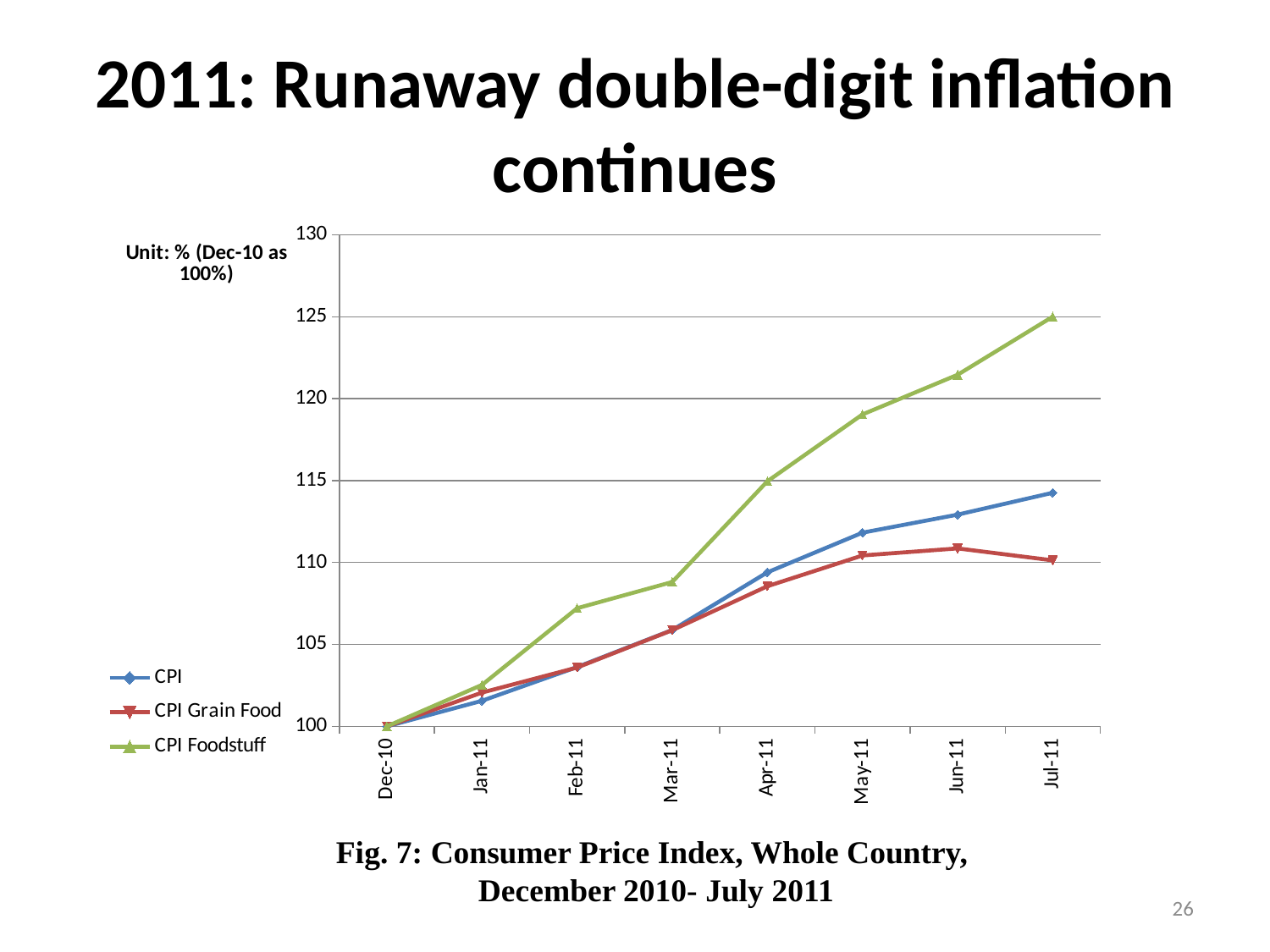
How many series does the legend list? 3 In Jul-11, which is larger: CPI or CPI Grain Food? CPI Is the value for CPI Foodstuff in Mar-11 greater or less than 110? less Which series has the lowest value in Jul-11? CPI Grain Food What is the caption of the chart? Fig. 7: Consumer Price Index, Whole Country, December 2010- July 2011 How many months are plotted along the x axis? 8 Which series has the highest value in Jul-11? CPI Foodstuff Is the value for CPI Foodstuff in Jul-11 greater or less than 120? greater Does the CPI Foodstuff series rise or fall from Dec-10 to Jul-11? rise Is the value for CPI in Jul-11 greater or less than 115? less What kind of chart is shown on the slide? line chart What is the value of CPI in Dec-10? 100